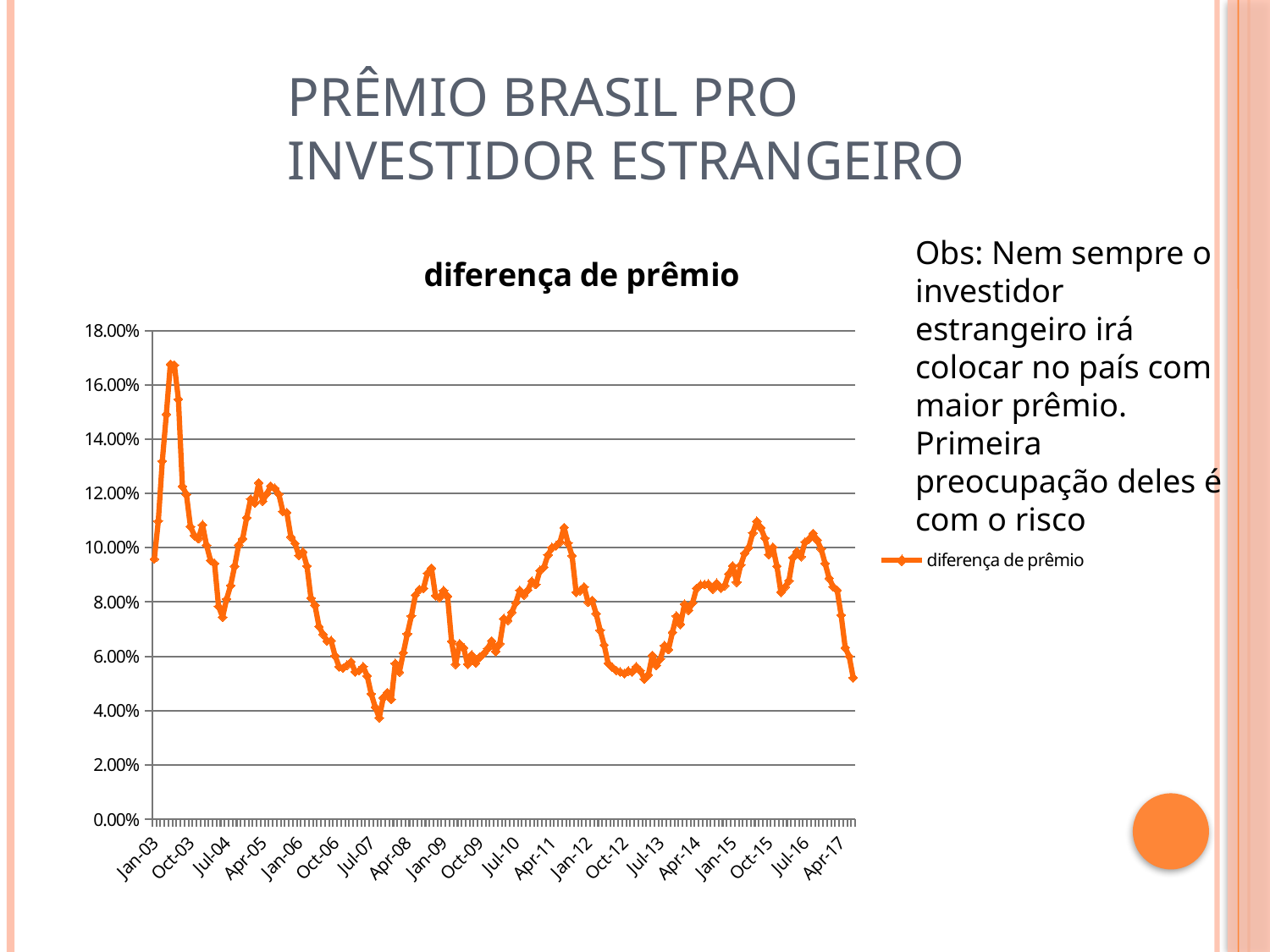
Is the value for Jan-03 greater or less than 8.00%? greater Is the value for Jul-07 greater or less than 6.00%? less What is the title of the chart? diferença de prêmio What kind of chart is shown on the slide? line chart How many series does the legend list? 1 What is the highest value shown on the vertical axis? 18.00% Which is larger, the value for Jan-03 or the value for Apr-17? Jan-03 Is the value for Oct-12 greater or less than 8.00%? less Overall, does the series rise or fall from Jan-03 to Apr-17? fall